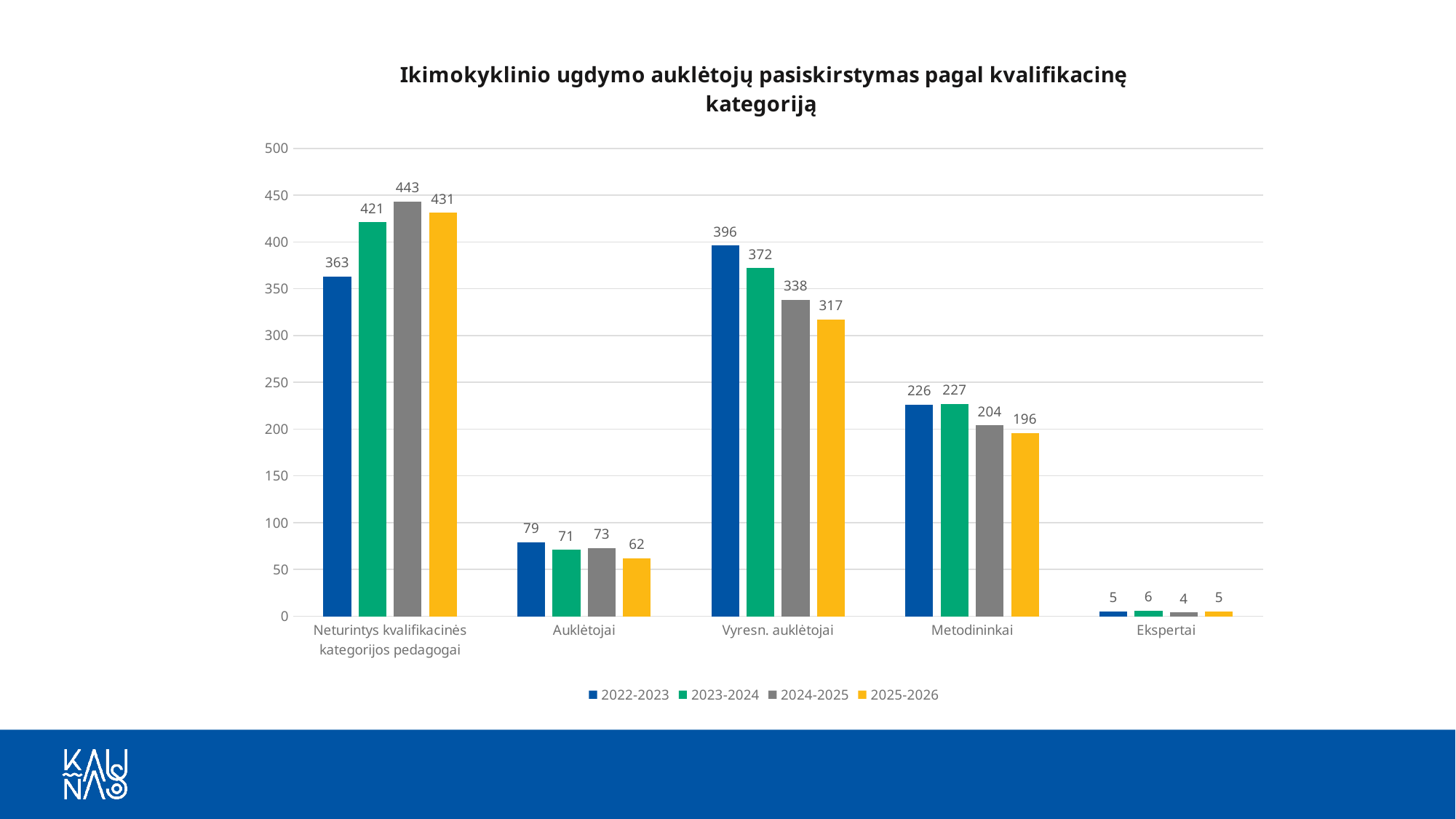
Which is larger for Metodininkai: the 2023-2024 value or the 2025-2026 value? 2023-2024 What is the difference between the 2024-2025 and 2022-2023 values for Neturintys kvalifikacinės kategorijos pedagogai? 80 Which category has the lowest value in the 2022-2023 series? Ekspertai How many series does the legend list? 4 What is the value for Auklėtojai in the 2024-2025 series? 73 How many categories are shown on the x axis? 5 Which category has the highest value in the 2024-2025 series? Neturintys kvalifikacinės kategorijos pedagogai What kind of chart is shown on the slide? bar chart What is the value for Vyresn. auklėtojai in the 2022-2023 series? 396 What is the difference between the 2022-2023 and 2025-2026 values for Vyresn. auklėtojai? 79 Do the values for Vyresn. auklėtojai rise or fall from 2022-2023 to 2025-2026? fall What is the value for Metodininkai in the 2025-2026 series? 196